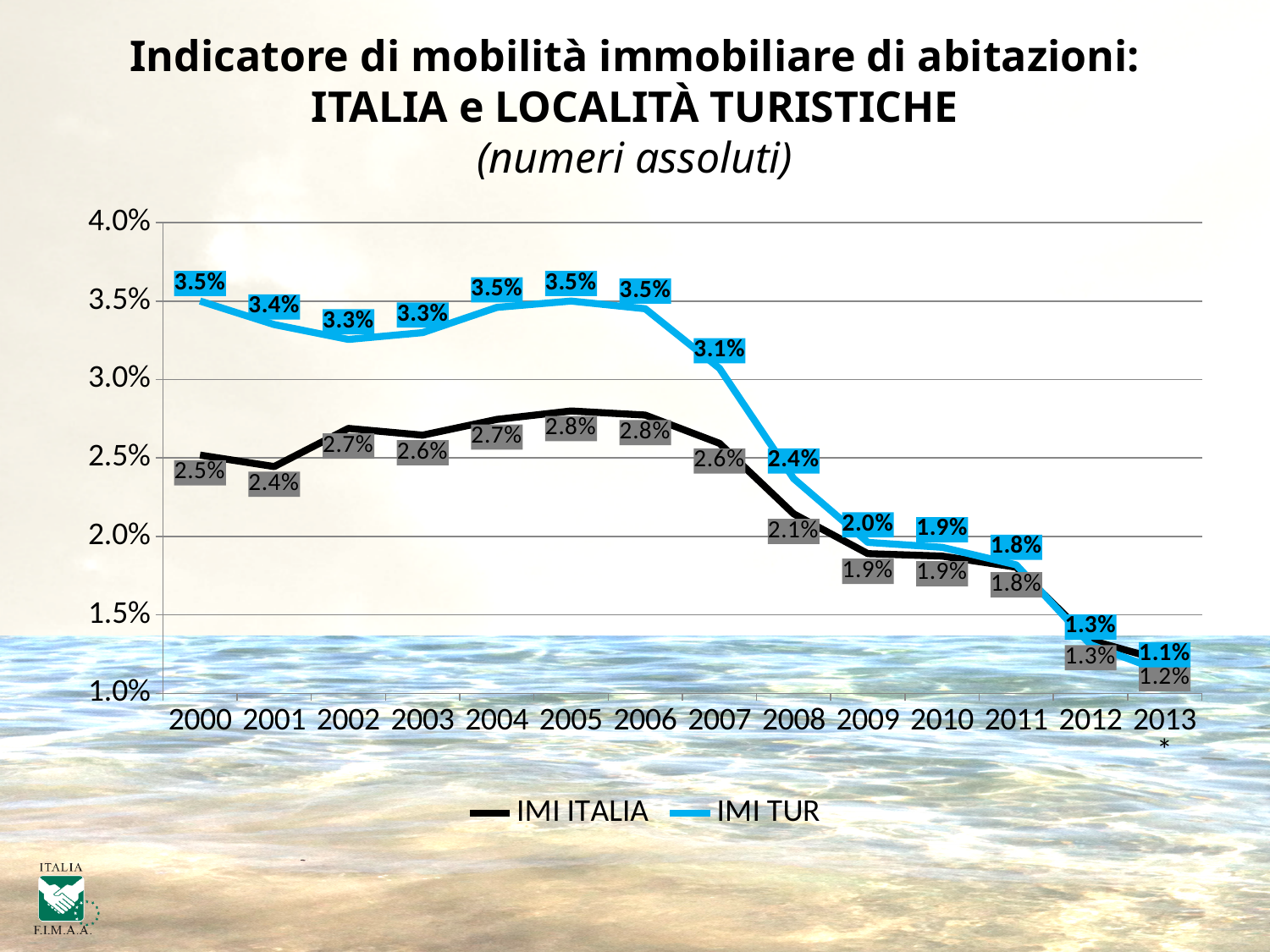
How many series does the legend list? 2 Does the IMI TUR series rise or fall from 2006 to 2013*? Fall What is the IMI TUR value for 2008? 2.4% In which year is the IMI TUR value lowest? 2013* How many years are shown on the x axis? 14 What is the IMI TUR value for 2007? 3.1% What is the IMI ITALIA value for 2005? 2.8% What is the IMI ITALIA value for 2013*? 1.2% What kind of chart is shown on the slide? Line chart Which series has the higher value in 2008, IMI ITALIA or IMI TUR? IMI TUR In which year is the IMI ITALIA value lowest? 2013* What is the difference between IMI TUR and IMI ITALIA in 2000? 1.0%